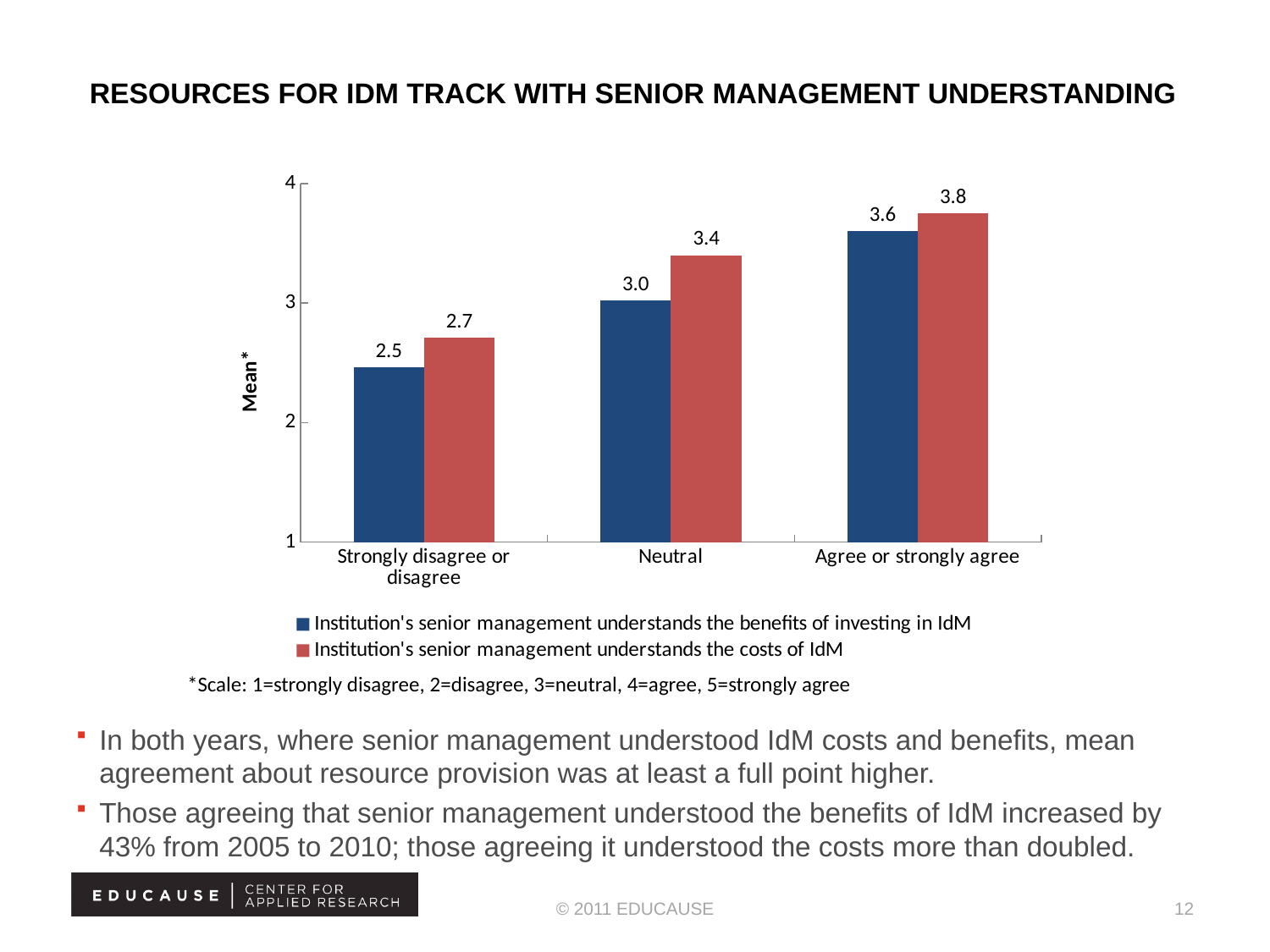
What kind of chart is shown on the slide? Bar chart What is the mean for 'Institution's senior management understands the costs of IdM' in the 'Agree or strongly agree' category? 3.8 How many categories are shown on the x axis? 3 What is the mean for 'Institution's senior management understands the benefits of investing in IdM' in the Neutral category? 3.0 What is the difference between the 'costs of IdM' mean for Neutral and for 'Strongly disagree or disagree'? 0.7 Which category has the lowest mean for 'Institution's senior management understands the benefits of investing in IdM'? Strongly disagree or disagree Do the means rise or fall moving from 'Strongly disagree or disagree' to 'Agree or strongly agree'? Rise How many series does the legend list? 2 What is the difference between the two series' means in the 'Agree or strongly agree' category? 0.2 What is the mean for 'Institution's senior management understands the benefits of investing in IdM' in the 'Strongly disagree or disagree' category? 2.5 Which category has the highest mean for 'Institution's senior management understands the costs of IdM'? Agree or strongly agree In the Neutral category, which series has the larger mean? Institution's senior management understands the costs of IdM